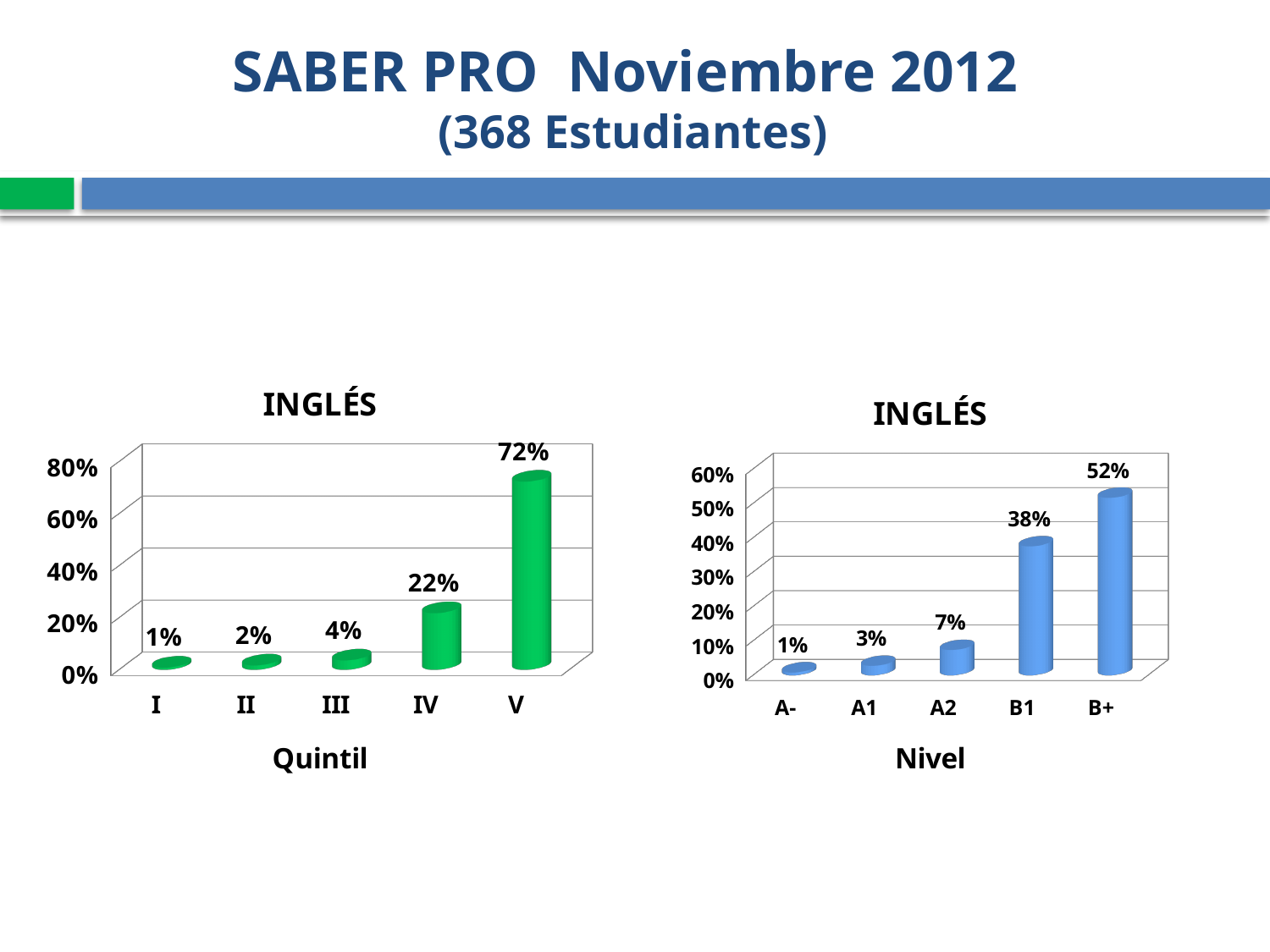
In the right chart (Nivel), which level has the highest value? B+ In the left chart (Quintil), how many quintile categories are shown? 5 In the left chart (Quintil), do the values rise or fall from quintile I to quintile V? rise In the right chart (Nivel), which is larger, the value for A1 or the value for A2? A2 In the right chart (Nivel), what is the value for level A2? 7% In the left chart (Quintil), what is the value for quintile IV? 22% In the right chart (Nivel), what is the difference between B+ and B1? 14% In the right chart (Nivel), what is the value for level B1? 38% In the left chart (Quintil), what is the value for quintile V? 72% What kind of chart is the right chart (Nivel)? bar chart In the left chart (Quintil), what is the difference between quintile V and quintile IV? 50% In the left chart (Quintil), which quintile has the lowest value? I